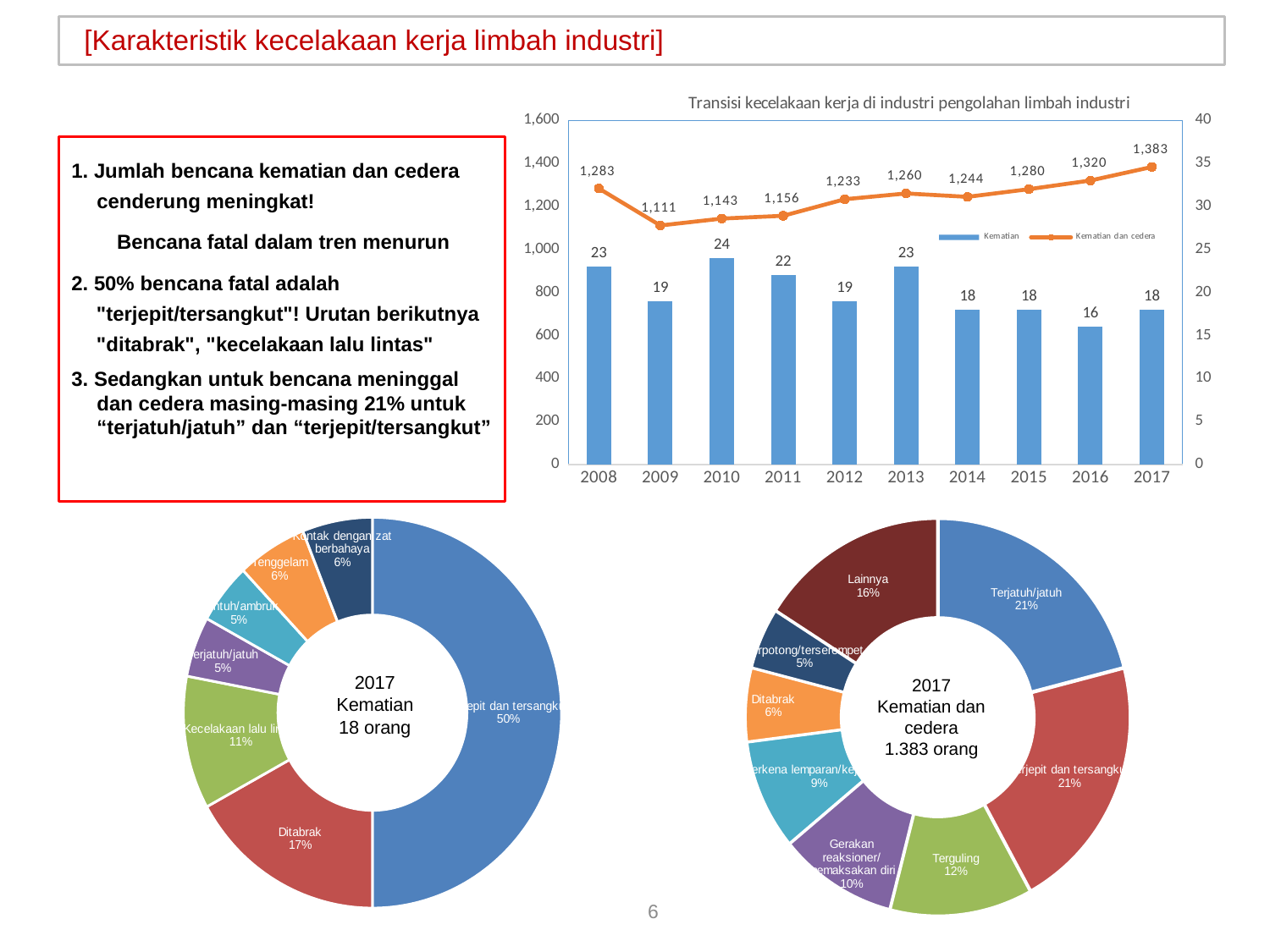
In the bottom-right donut chart (2017 Kematian dan cedera 1.383 orang), which is larger, the share for Lainnya or the share for Ditabrak? Lainnya In the chart titled 'Transisi kecelakaan kerja di industri pengolahan limbah industri', does the Kematian dan cedera line rise or fall from 2013 to 2017? rise In the bottom-right donut chart (2017 Kematian dan cedera 1.383 orang), what share does Terguling have? 12% In the chart titled 'Transisi kecelakaan kerja di industri pengolahan limbah industri', what is the Kematian dan cedera value for 2017? 1,383 In the bottom-left donut chart (2017 Kematian 18 orang), which category has the largest share? Terjepit dan tersangkut In the chart titled 'Transisi kecelakaan kerja di industri pengolahan limbah industri', which year has the lowest Kematian value? 2016 In the chart titled 'Transisi kecelakaan kerja di industri pengolahan limbah industri', what is the difference between the Kematian dan cedera values for 2017 and 2016? 63 In the chart titled 'Transisi kecelakaan kerja di industri pengolahan limbah industri', how many years are shown on the x axis? 10 In the chart titled 'Transisi kecelakaan kerja di industri pengolahan limbah industri', what is the Kematian value for 2010? 24 In the bottom-left donut chart (2017 Kematian 18 orang), what share does Ditabrak have? 17% In the chart titled 'Transisi kecelakaan kerja di industri pengolahan limbah industri', how many series does the legend list? 2 In the chart titled 'Transisi kecelakaan kerja di industri pengolahan limbah industri', which year has the lowest Kematian dan cedera value? 2009